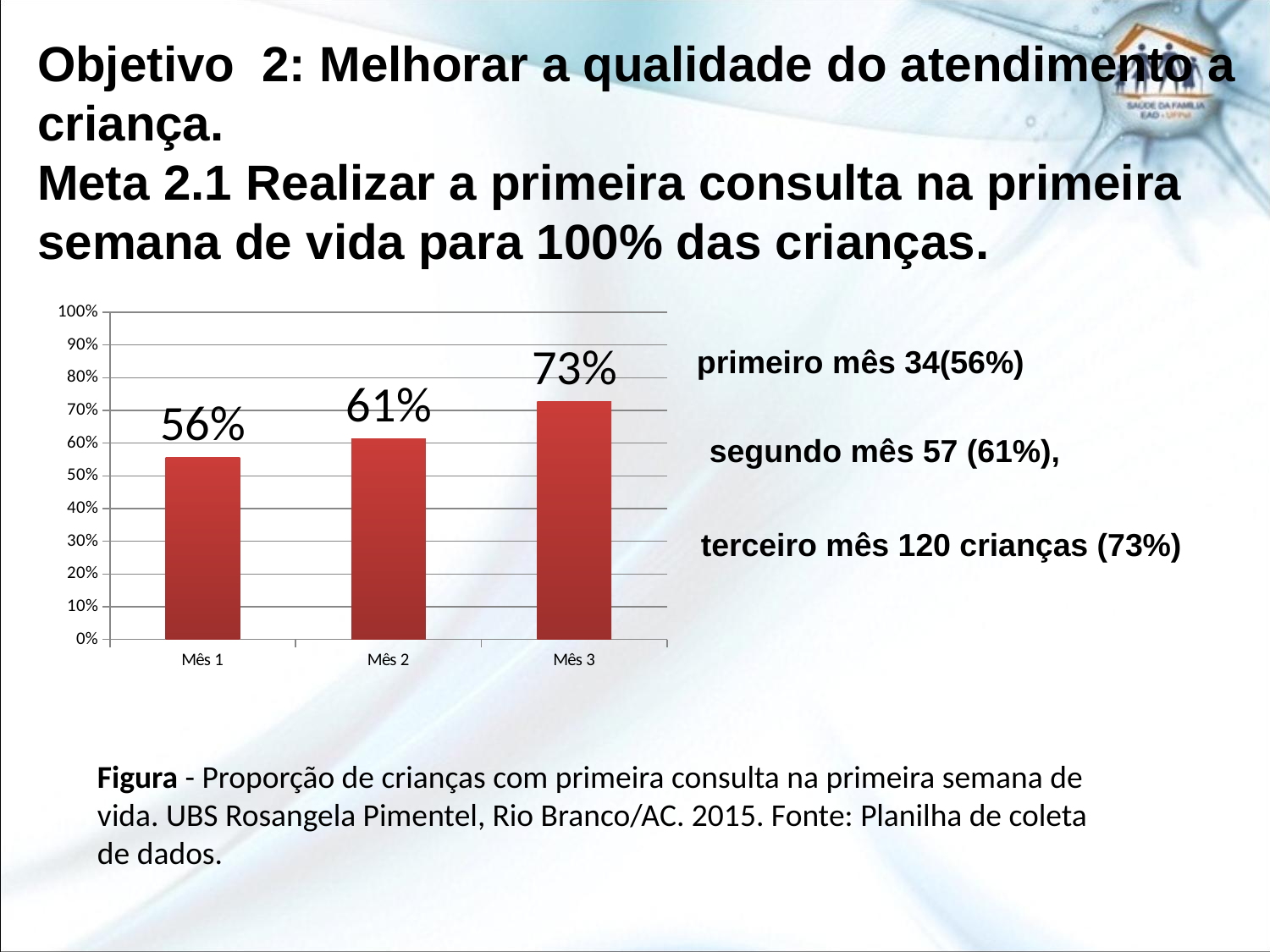
What is the value for Mês 3? 73% What is the value for Mês 2? 61% Is the value for Mês 3 greater or less than 70%? greater What is the difference between the values for Mês 2 and Mês 1? 5% Do the values rise or fall from Mês 1 to Mês 3? rise What kind of chart is shown? bar chart What is the value for Mês 1? 56% Which month has the highest value? Mês 3 What is the difference between the values for Mês 3 and Mês 1? 17% Which month has the lowest value? Mês 1 How many months are shown on the x axis? 3 Which is larger, the value for Mês 2 or the value for Mês 3? Mês 3